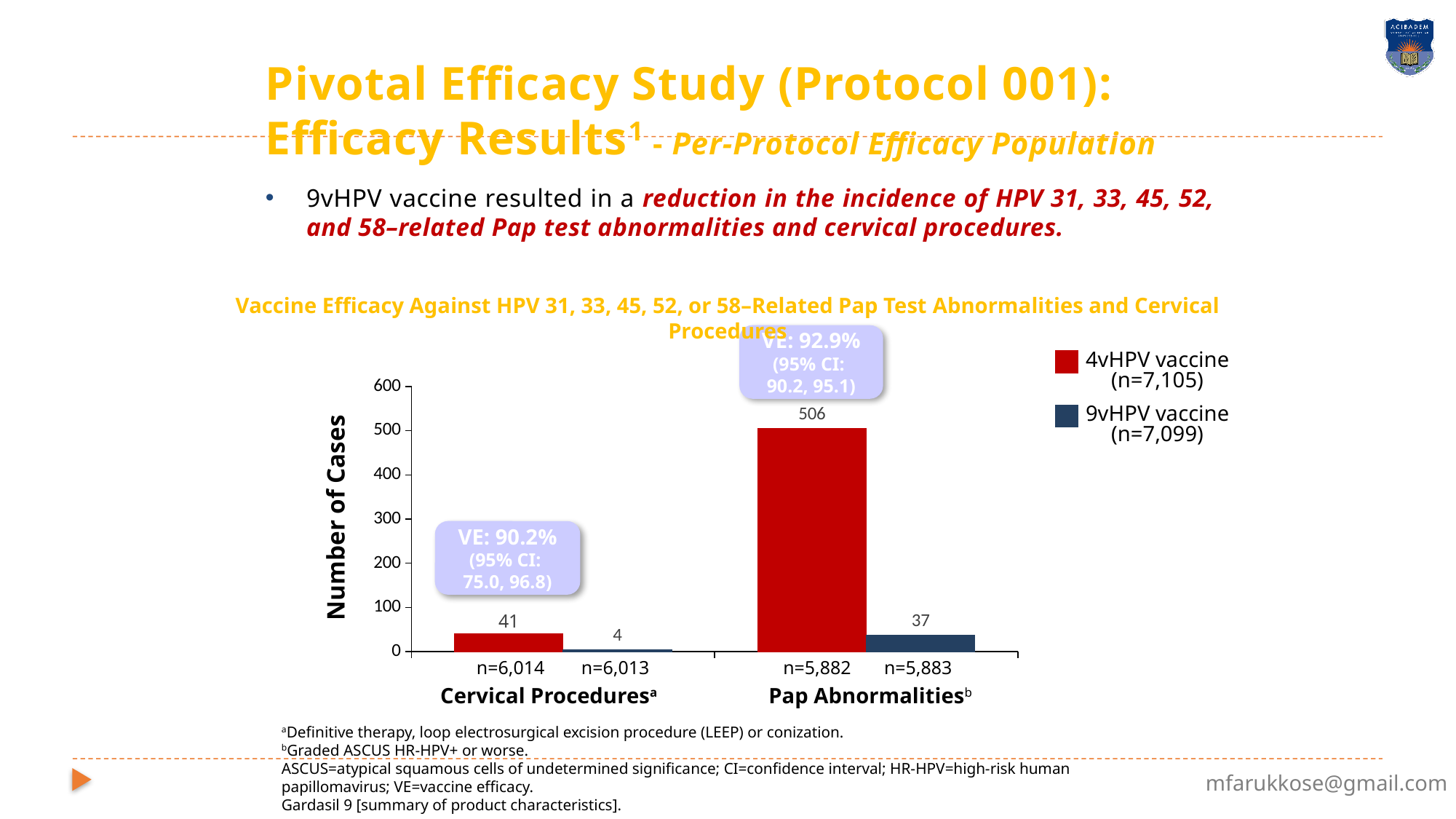
What is the number of cases for the 4vHPV vaccine in the Cervical Procedures category? 41 What is the vaccine efficacy (VE) shown for Pap Abnormalities? 92.9% What is the difference in cases between the 4vHPV and 9vHPV vaccines in the Cervical Procedures category? 37 Which bar shows the highest number of cases? 4vHPV vaccine, Pap Abnormalities What is the number of cases for the 9vHPV vaccine in the Pap Abnormalities category? 37 Which bar shows the lowest number of cases? 9vHPV vaccine, Cervical Procedures What is the number of cases for the 4vHPV vaccine in the Pap Abnormalities category? 506 How many series does the legend list? 2 What is the number of cases for the 9vHPV vaccine in the Cervical Procedures category? 4 Which vaccine has more cases in the Cervical Procedures category, 4vHPV or 9vHPV? 4vHPV vaccine What kind of chart is shown on the slide? Bar chart What is the difference in cases between the 4vHPV and 9vHPV vaccines in the Pap Abnormalities category? 469